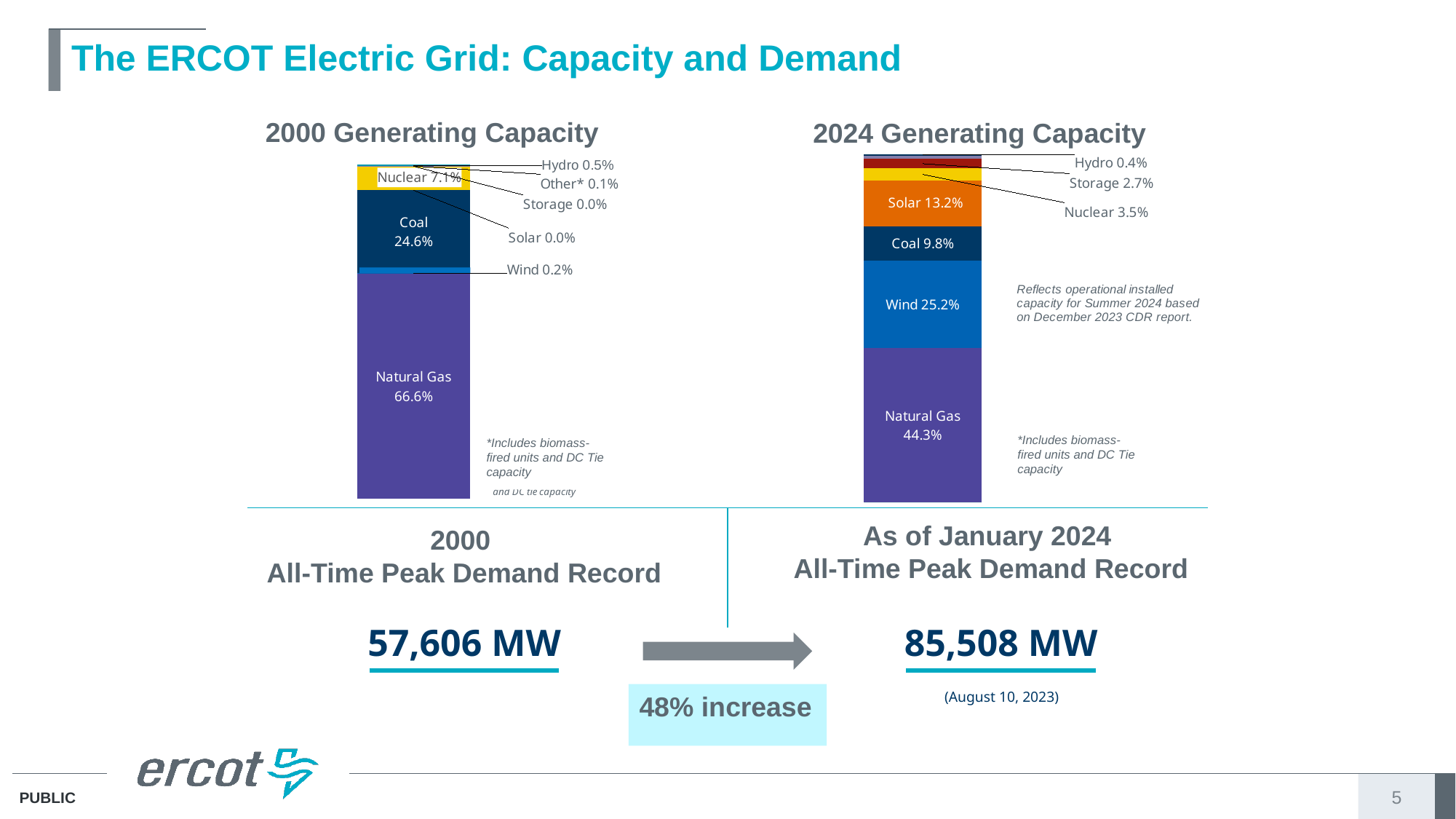
What type of chart is used to show the 2000 and 2024 Generating Capacity? Stacked bar chart What is the difference between the Natural Gas share in the 2000 Generating Capacity chart and in the 2024 Generating Capacity chart? 22.3% In the 2024 Generating Capacity chart, which source has the largest share? Natural Gas How many sources are labelled in the 2000 Generating Capacity chart? 8 In the 2024 Generating Capacity chart, what share of capacity is Wind? 25.2% In the 2000 Generating Capacity chart, what share of capacity is Natural Gas? 66.6% In the 2000 Generating Capacity chart, what share of capacity is Coal? 24.6% In the 2024 Generating Capacity chart, what share of capacity is Storage? 2.7% In the 2024 Generating Capacity chart, what is the difference between the Wind share and the Coal share? 15.4% In the 2024 Generating Capacity chart, which is larger, Coal or Solar? Solar In the 2000 Generating Capacity chart, which source has the largest share? Natural Gas In the 2024 Generating Capacity chart, what share of capacity is Solar? 13.2%